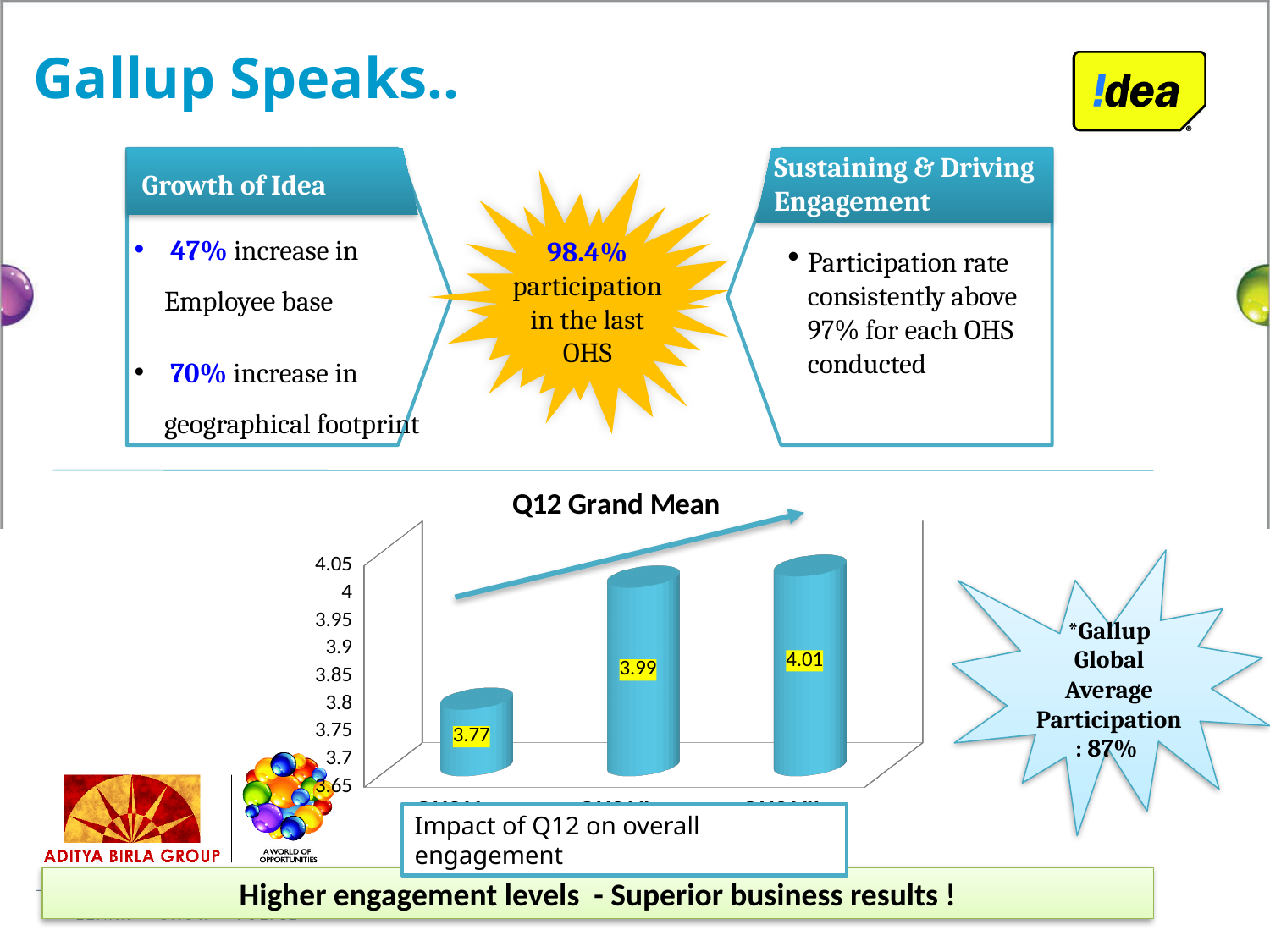
What is the value of the leftmost bar in the Q12 Grand Mean chart? 3.77 Do the values in the Q12 Grand Mean chart rise or fall from left to right? rise Which is larger in the Q12 Grand Mean chart, the middle bar or the rightmost bar? the rightmost bar Which bar in the Q12 Grand Mean chart has the lowest value? the leftmost bar (3.77) What is the difference between the rightmost bar and the leftmost bar in the Q12 Grand Mean chart? 0.24 What kind of chart is shown on the slide? bar chart Is the value of the leftmost bar in the Q12 Grand Mean chart greater or less than 3.9? less How many bars are plotted in the Q12 Grand Mean chart? 3 Which bar in the Q12 Grand Mean chart has the highest value? the rightmost bar (4.01) What is the value of the middle bar in the Q12 Grand Mean chart? 3.99 What is the value of the rightmost bar in the Q12 Grand Mean chart? 4.01 What is the title of the chart on the slide? Q12 Grand Mean